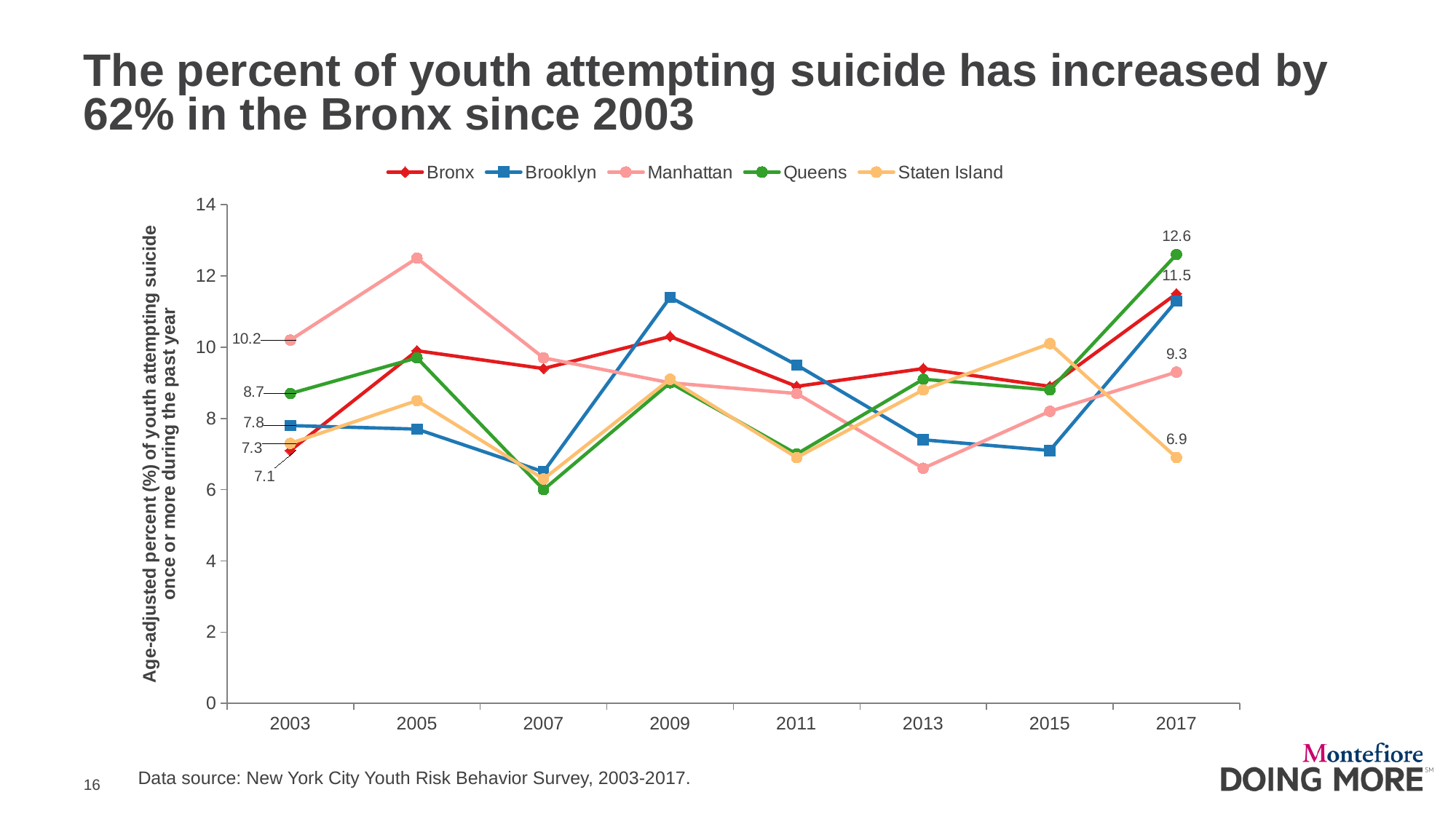
Which borough had the lowest value in 2003? Bronx Which borough had the highest value in 2017? Queens By how much did the Bronx value increase from 2003 (7.1) to 2017 (11.5)? 4.4 How many years are plotted along the x axis? 8 What was the age-adjusted percent of youth attempting suicide in the Bronx in 2003? 7.1 How many series does the legend list? 5 Is the value for Brooklyn in 2009 greater or less than 10? greater What was the value for Queens in 2017? 12.6 What was the value for Staten Island in 2017? 6.9 Which was larger in 2003, the value for Manhattan or the value for Queens? Manhattan What was the value for Manhattan in 2003? 10.2 What kind of chart is shown on the slide? Line chart